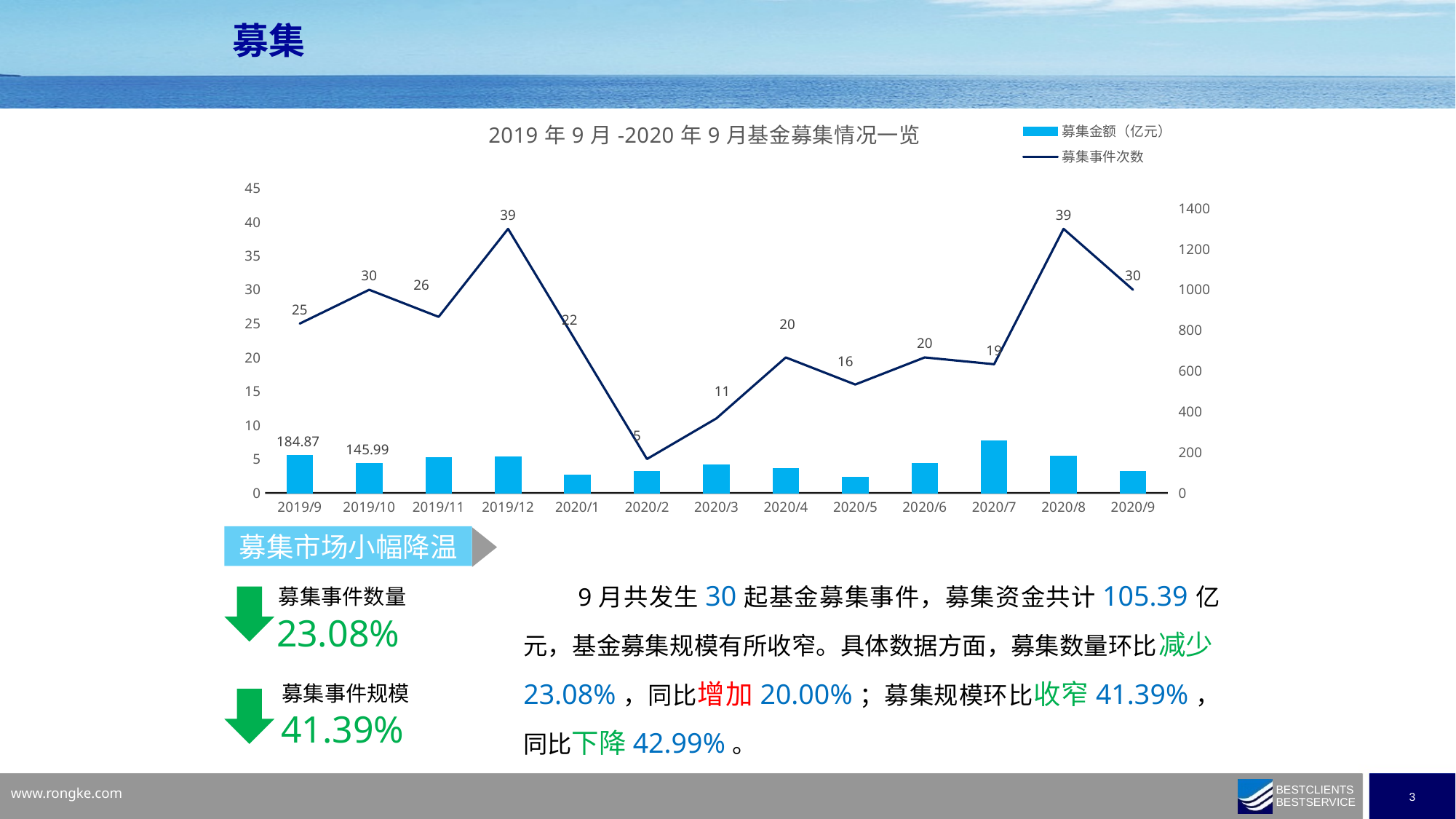
How many months are shown on the x axis? 13 What is the difference between the 募集事件次数 values for 2019/12 and 2020/2? 34 Does the 募集事件次数 line rise or fall from 2020/2 to 2020/4? rise What is the difference between the 募集金额（亿元） values for 2019/9 and 2019/10? 38.88 How many series does the legend list? 2 In which month is the 募集事件次数 lowest? 2020/2 What is the 募集事件次数 value for 2020/2? 5 In which month is the 募集金额（亿元） bar the highest? 2020/7 What is the 募集金额（亿元） value for 2019/9? 184.87 What is the 募集事件次数 value for 2019/12? 39 Is the 募集金额（亿元） value for 2020/7 greater or less than 200? greater What is the 募集金额（亿元） value for 2019/10? 145.99